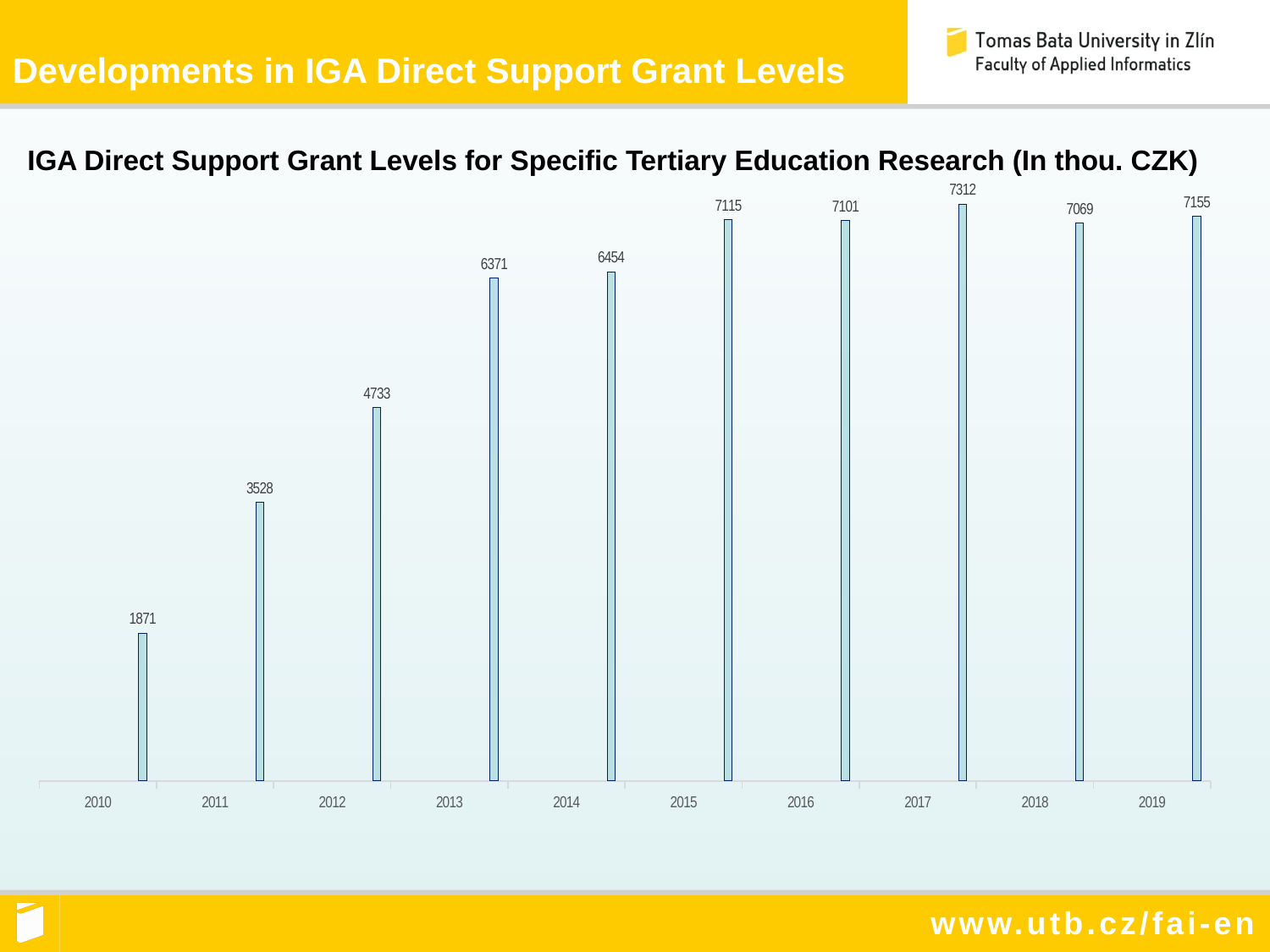
What is the value shown for 2017? 7312 What is the value shown for 2013? 6371 Which year has the highest grant level? 2017 Which year has the lowest grant level? 2010 What is the IGA direct support grant level for 2010? 1871 Which is larger, the value for 2012 or the value for 2014? 2014 Do the values generally rise or fall from 2010 to 2017? Rise How many years are shown on the x axis? 10 In what unit are the grant levels expressed according to the chart title? thou. CZK What is the difference between the values for 2011 and 2010? 1657 What is the difference between the values for 2019 and 2018? 86 What kind of chart is shown on the slide? Bar chart